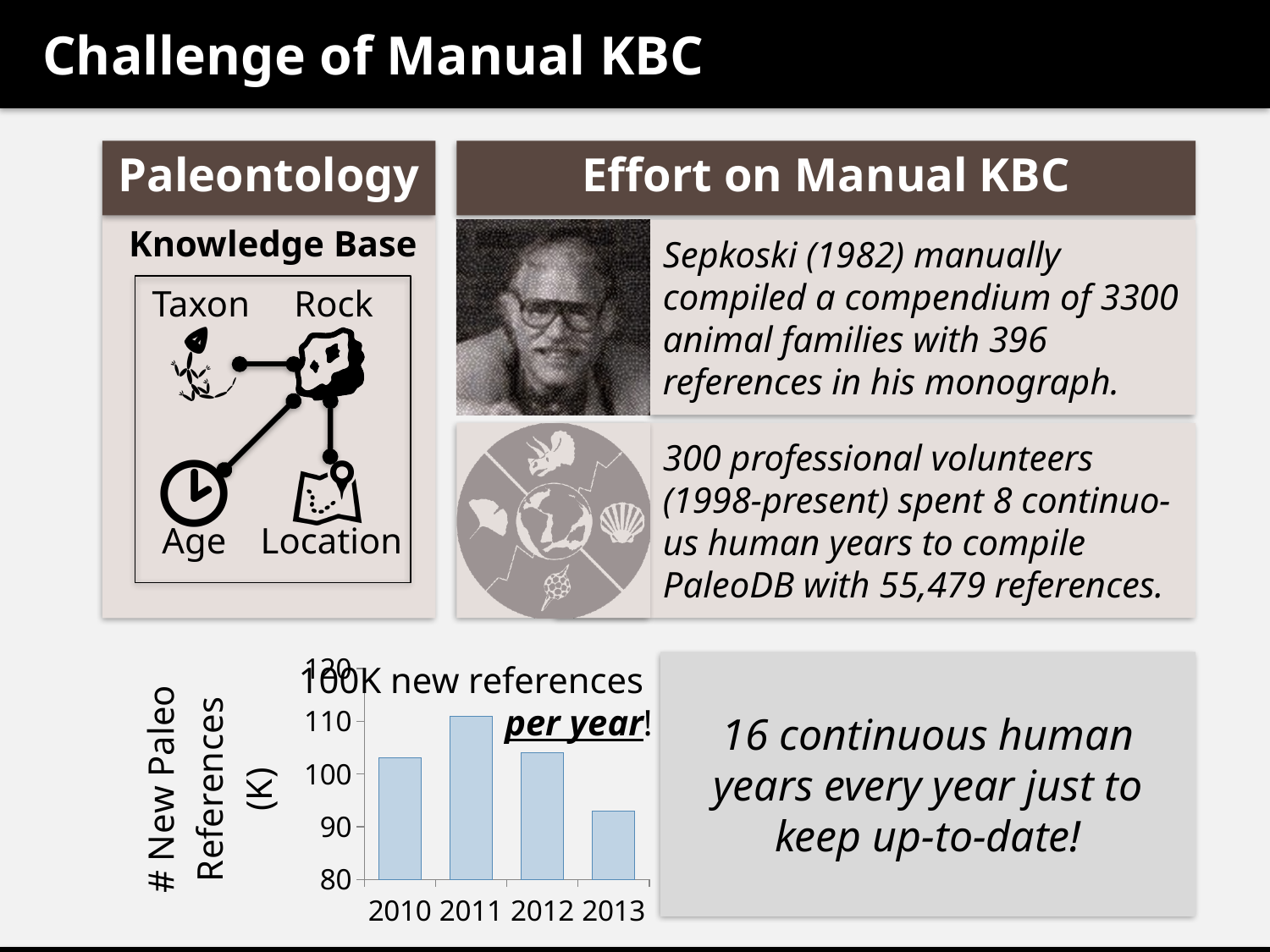
From 2011 to 2013, do the values in the bar chart rise or fall? fall Is the value for 2013 greater or less than 100? less How many years are plotted in the bar chart? 4 What kind of chart is shown at the bottom of the slide? bar chart What is the label on the y axis of the bar chart? # New Paleo References (K) Is the value for 2013 greater or less than 90? greater Which year has the larger value in the bar chart, 2011 or 2013? 2011 Which year has the highest number of new paleo references in the bar chart? 2011 Which year has the lowest number of new paleo references in the bar chart? 2013 Is the value for 2011 greater or less than 100? greater What annotation is written over the bar chart? 100K new references per year!